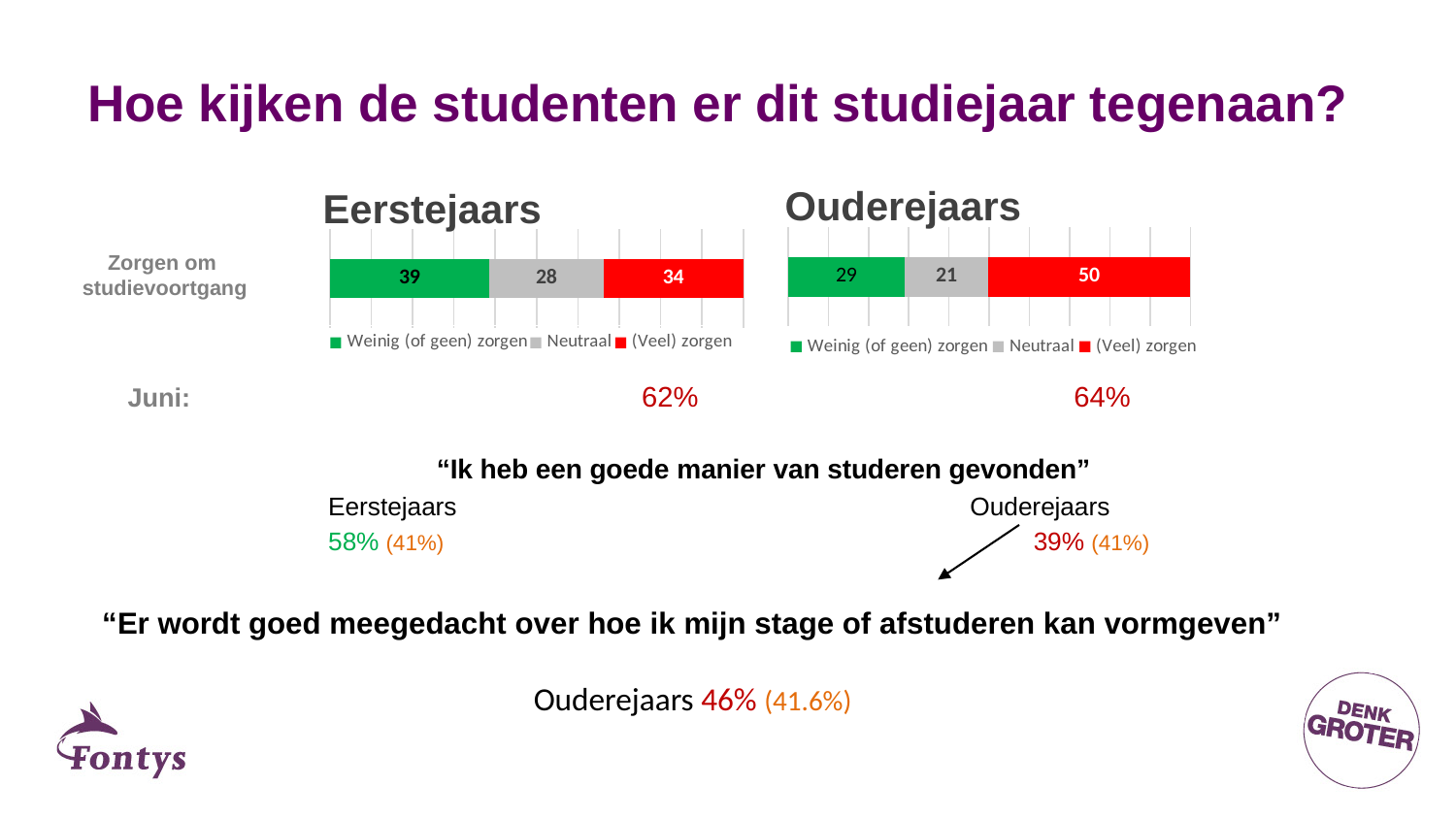
In the Eerstejaars chart, what is the value for Weinig (of geen) zorgen? 39 In the Eerstejaars chart, which segment has the lowest value? Neutraal How many series does the legend of the Eerstejaars chart list? 3 In the Ouderejaars chart, what is the value for Neutraal? 21 In the Ouderejaars chart, which segment has the highest value? (Veel) zorgen In the Ouderejaars chart, what is the difference between (Veel) zorgen and Weinig (of geen) zorgen? 21 What is the total of the stacked bar in the Eerstejaars chart? 101 In the Eerstejaars chart, what is the value for Neutraal? 28 What kind of chart is the Ouderejaars chart? Stacked bar chart What colour represents (Veel) zorgen in the Ouderejaars chart? Red In the Ouderejaars chart, what is the value for (Veel) zorgen? 50 Which is larger: (Veel) zorgen in the Eerstejaars chart or (Veel) zorgen in the Ouderejaars chart? Ouderejaars